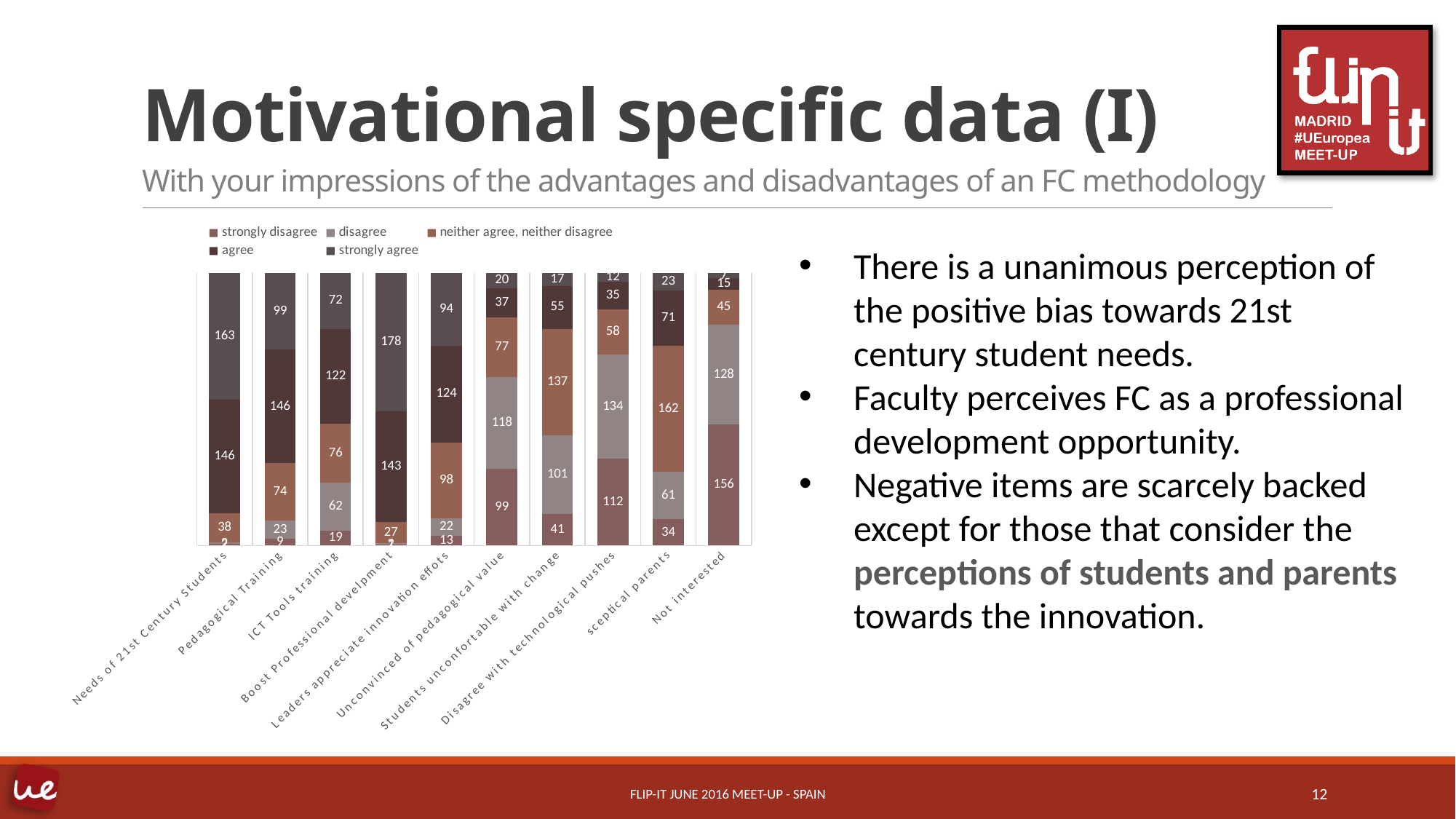
What kind of chart is shown on the slide? stacked bar chart Which category has the highest 'strongly agree' value? Boost Professional development What is the 'strongly agree' value for Boost Professional development? 178 What is the 'disagree' value for Disagree with technological pushes? 134 What is the total of the stacked bar for Students uncomfortable with change? 351 Which is larger: the 'strongly agree' value for Pedagogical Training or for Leaders appreciate innovation efforts? Pedagogical Training How many categories are shown on the x axis? 10 What is the 'neither agree, neither disagree' value for sceptical parents? 162 How many series does the legend list? 5 What is the difference between the 'agree' values for Pedagogical Training and ICT Tools training? 24 Which category has the highest 'strongly disagree' value? Not interested What is the 'strongly disagree' value for Not interested? 156